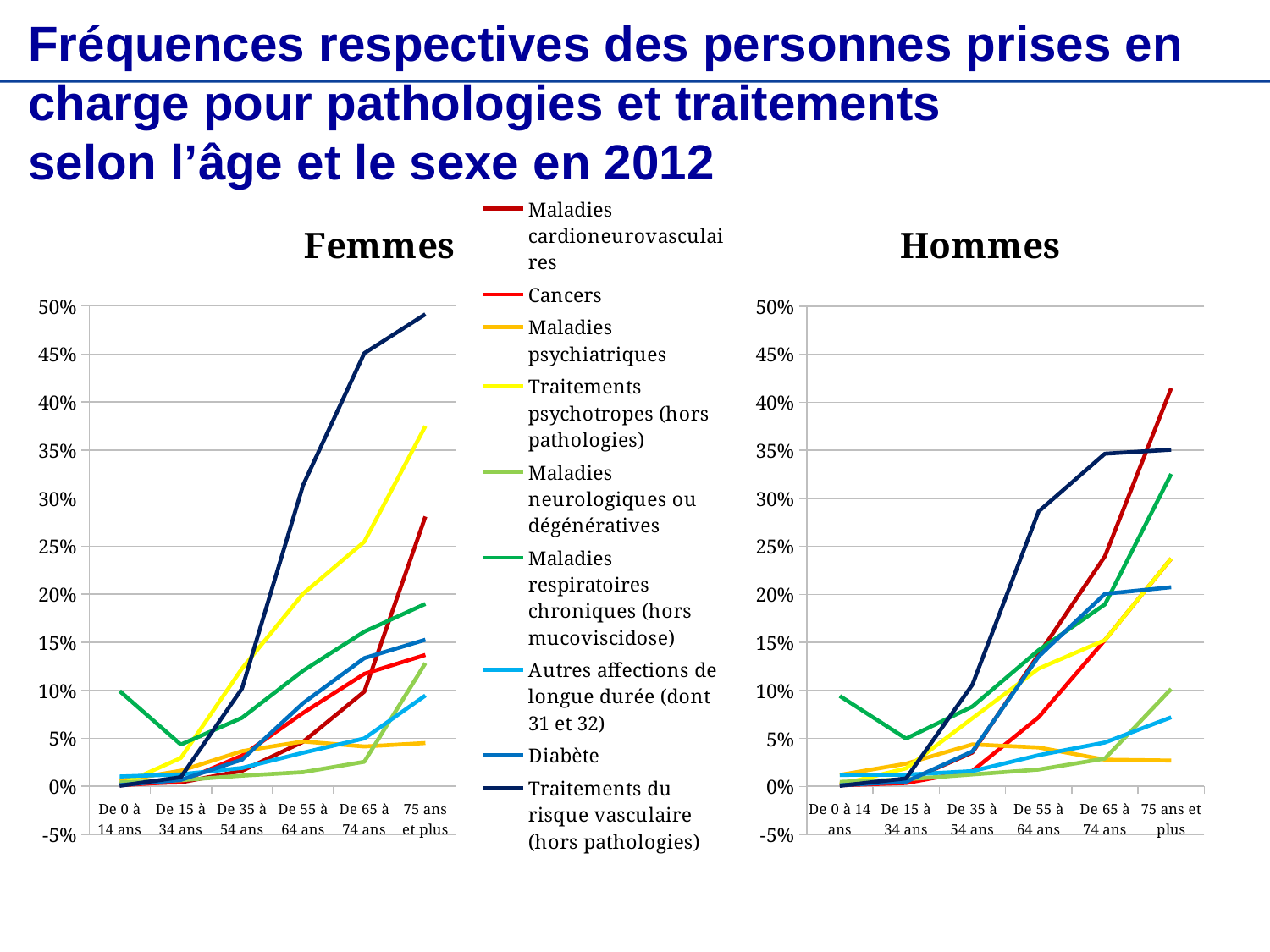
In the 'Hommes' chart, is the value for 'Traitements psychotropes (hors pathologies)' at '75 ans et plus' greater or less than 25%? less What is the highest value shown on the y axis of the 'Hommes' chart? 50% At '75 ans et plus', is the value for 'Traitements psychotropes (hors pathologies)' larger in the 'Femmes' chart or the 'Hommes' chart? Femmes In the 'Femmes' chart, does the 'Traitements du risque vasculaire (hors pathologies)' series rise or fall from 'De 0 à 14 ans' to '75 ans et plus'? rise In the 'Femmes' chart, is the value for 'Maladies psychiatriques' at '75 ans et plus' greater or less than 10%? less How many age categories are shown on the x axis of the 'Hommes' chart? 6 In the 'Femmes' chart, which series has the highest value at '75 ans et plus'? Traitements du risque vasculaire (hors pathologies) How many series does the legend list? 9 In the 'Hommes' chart, is the value for 'Maladies respiratoires chroniques (hors mucoviscidose)' at '75 ans et plus' greater or less than 30%? greater What type of chart is the 'Femmes' chart? line chart